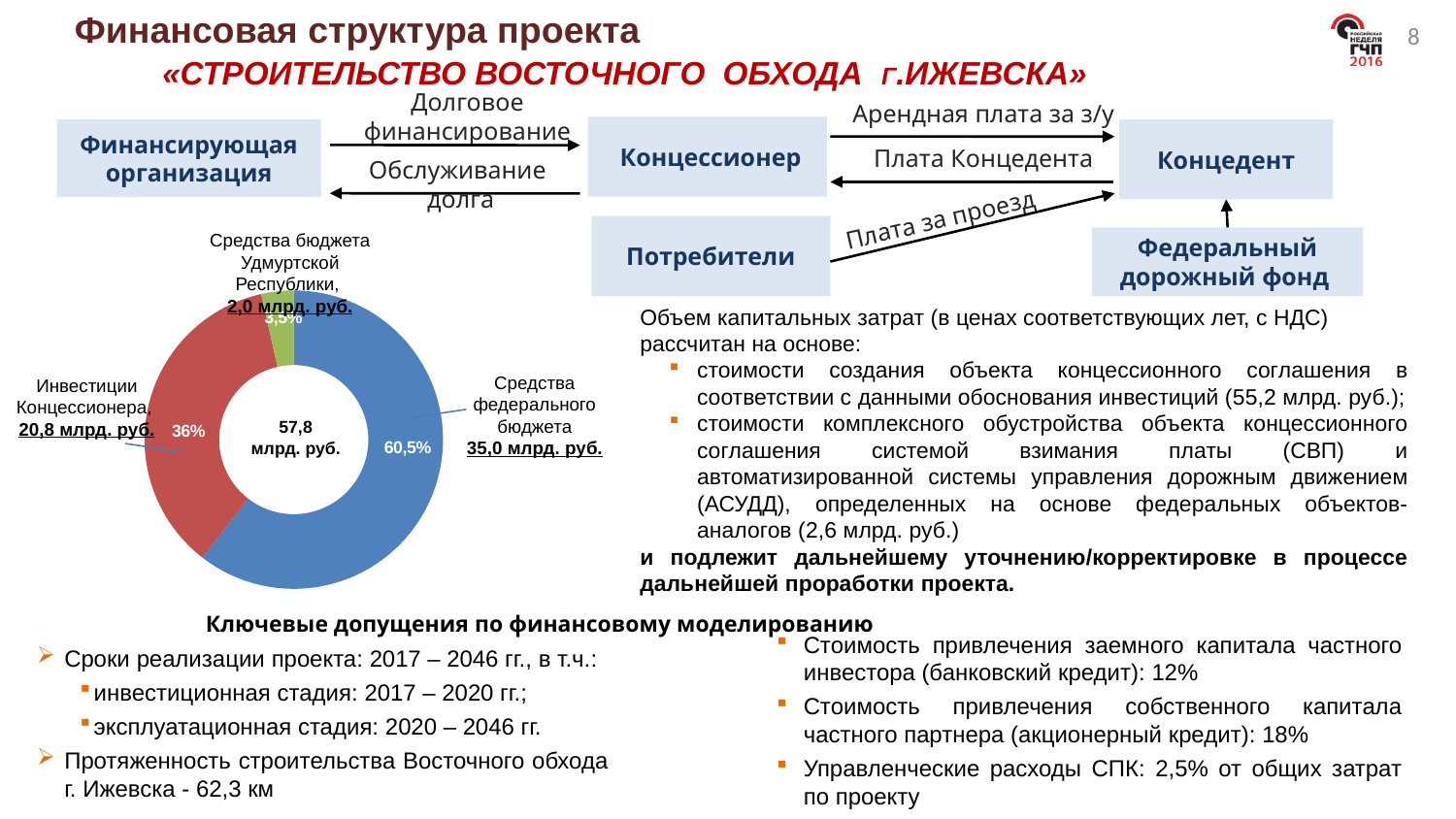
Which is larger in the doughnut chart: Инвестиции Концессионера or Средства бюджета Удмуртской Республики? Инвестиции Концессионера What share of the doughnut chart does Инвестиции Концессионера represent? 36% What is the value for Средства федерального бюджета in the doughnut chart? 35,0 млрд. руб. What type of chart is shown on the left of the slide? Doughnut (pie) chart Which source has the largest share in the doughnut chart? Средства федерального бюджета What is the value for Инвестиции Концессионера in the doughnut chart? 20,8 млрд. руб. What is the difference between Средства федерального бюджета and Инвестиции Концессионера in the doughnut chart? 14,2 млрд. руб. What total value is shown in the center of the doughnut chart? 57,8 млрд. руб. How many slices does the doughnut chart have? 3 Which source has the smallest share in the doughnut chart? Средства бюджета Удмуртской Республики What is the value for Средства бюджета Удмуртской Республики in the doughnut chart? 2,0 млрд. руб. What share of the doughnut chart does Средства федерального бюджета represent? 60,5%